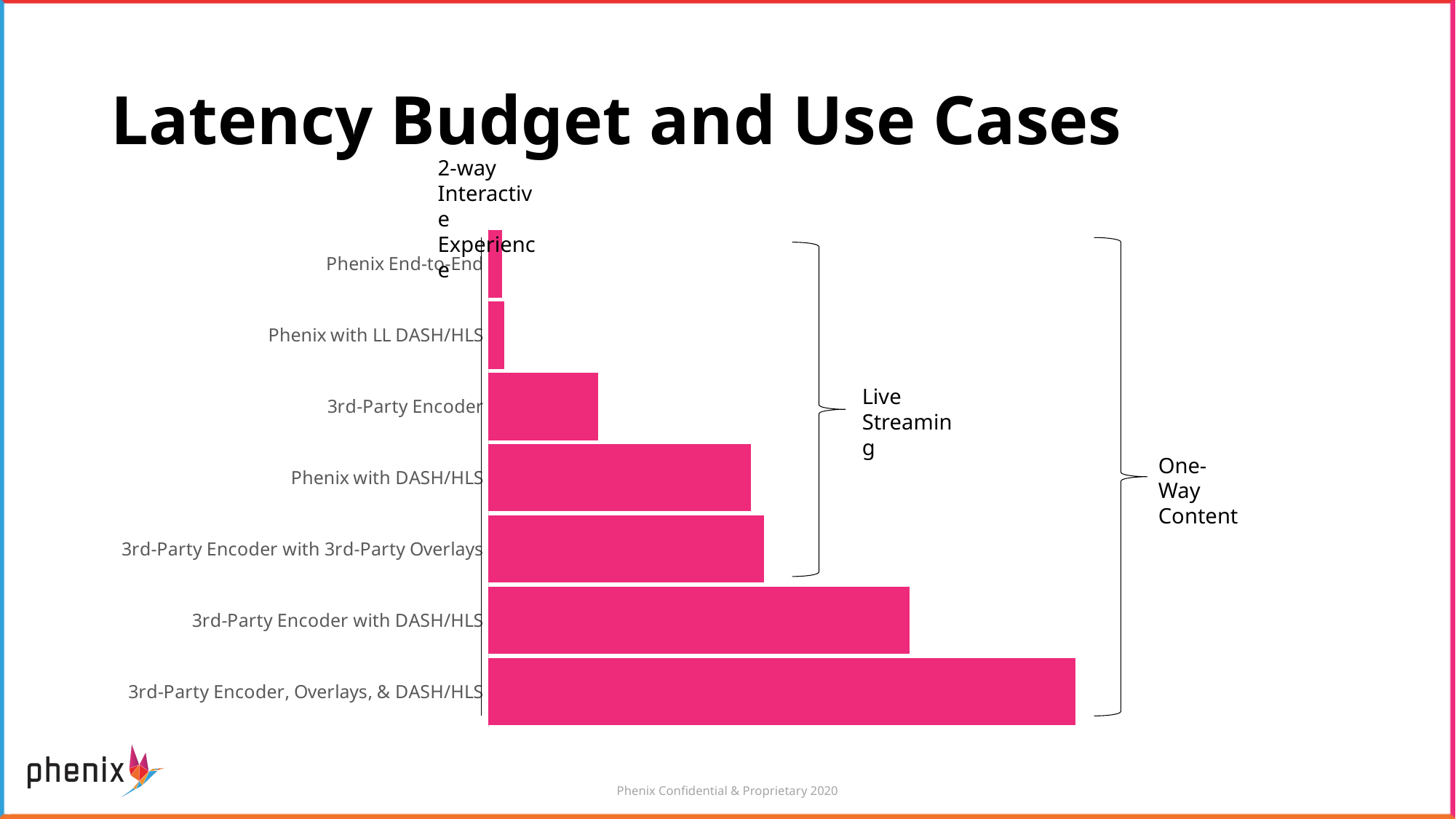
What is the title of the slide containing the chart? Latency Budget and Use Cases Which bar is longer: Phenix with LL DASH/HLS or 3rd-Party Encoder with DASH/HLS? 3rd-Party Encoder with DASH/HLS Which category is listed at the top of the chart? Phenix End-to-End Which category has the longest bar in the chart? 3rd-Party Encoder, Overlays, & DASH/HLS What kind of chart is shown on the slide? Bar chart Which bar is longer: Phenix End-to-End or 3rd-Party Encoder? 3rd-Party Encoder Which bar is longer: 3rd-Party Encoder with DASH/HLS or 3rd-Party Encoder with 3rd-Party Overlays? 3rd-Party Encoder with DASH/HLS Do the bar lengths increase or decrease going from the top category to the bottom category? Increase How many categories (bars) does the chart show? 7